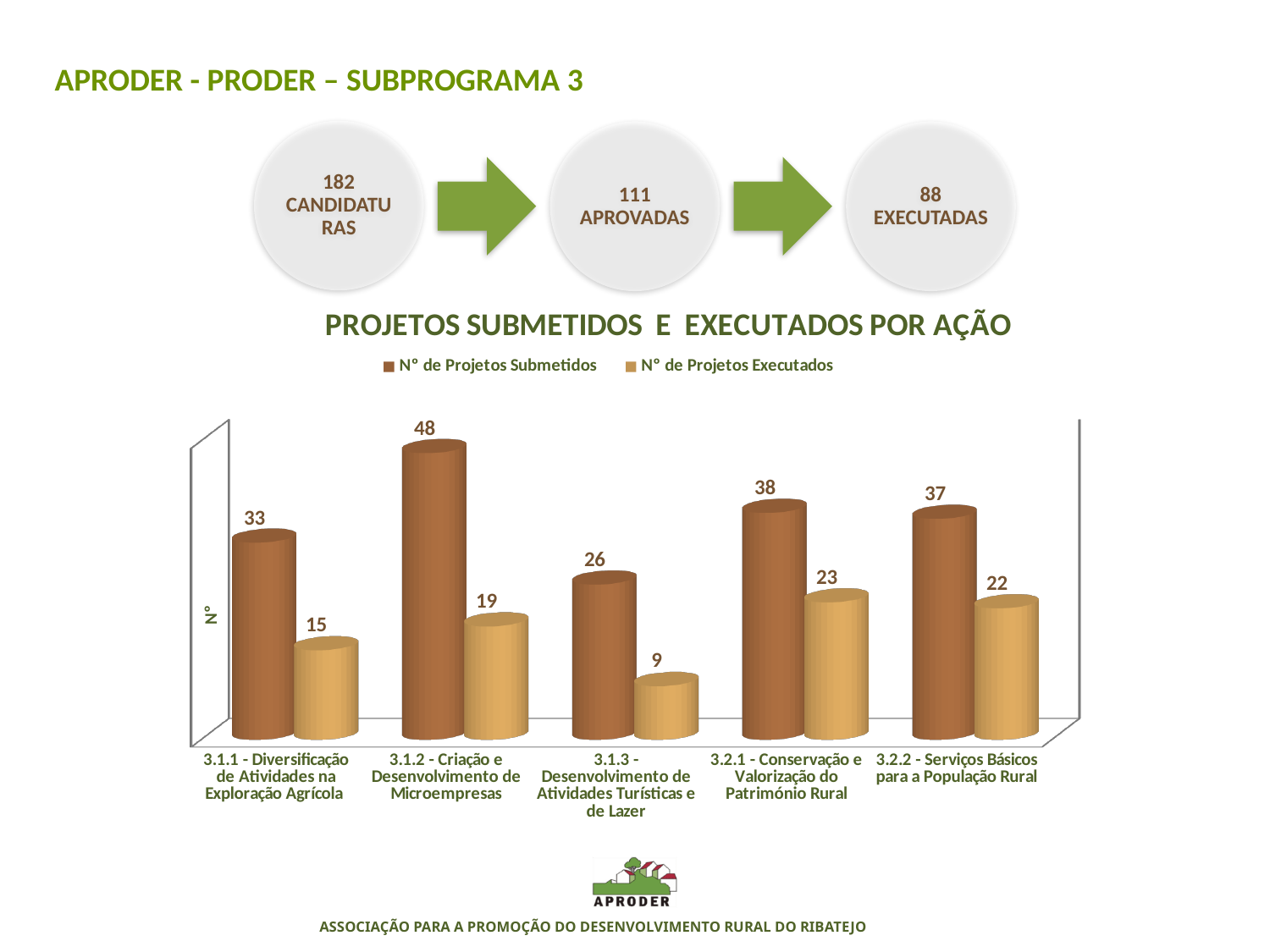
What is the number of projects executed (Nº de Projetos Executados) for 3.1.3 - Desenvolvimento de Atividades Turísticas e de Lazer? 9 What kind of chart is shown on the slide? Bar chart Which is larger: the number of projects executed for 3.1.2 - Criação e Desenvolvimento de Microempresas or for 3.2.2 - Serviços Básicos para a População Rural? 3.2.2 - Serviços Básicos para a População Rural How many series does the chart legend list? 2 How many actions (categories) are shown on the x axis of the chart? 5 What is the number of projects executed for 3.2.1 - Conservação e Valorização do Património Rural? 23 What is the difference in projects submitted between 3.1.2 - Criação e Desenvolvimento de Microempresas and 3.1.3 - Desenvolvimento de Atividades Turísticas e de Lazer? 22 Which action has the highest number of projects submitted? 3.1.2 - Criação e Desenvolvimento de Microempresas What is the title of the chart? PROJETOS SUBMETIDOS E EXECUTADOS POR AÇÃO Which action has the lowest number of projects executed? 3.1.3 - Desenvolvimento de Atividades Turísticas e de Lazer What is the difference between projects submitted and projects executed for 3.1.1 - Diversificação de Atividades na Exploração Agrícola? 18 What is the number of projects submitted (Nº de Projetos Submetidos) for 3.1.2 - Criação e Desenvolvimento de Microempresas? 48